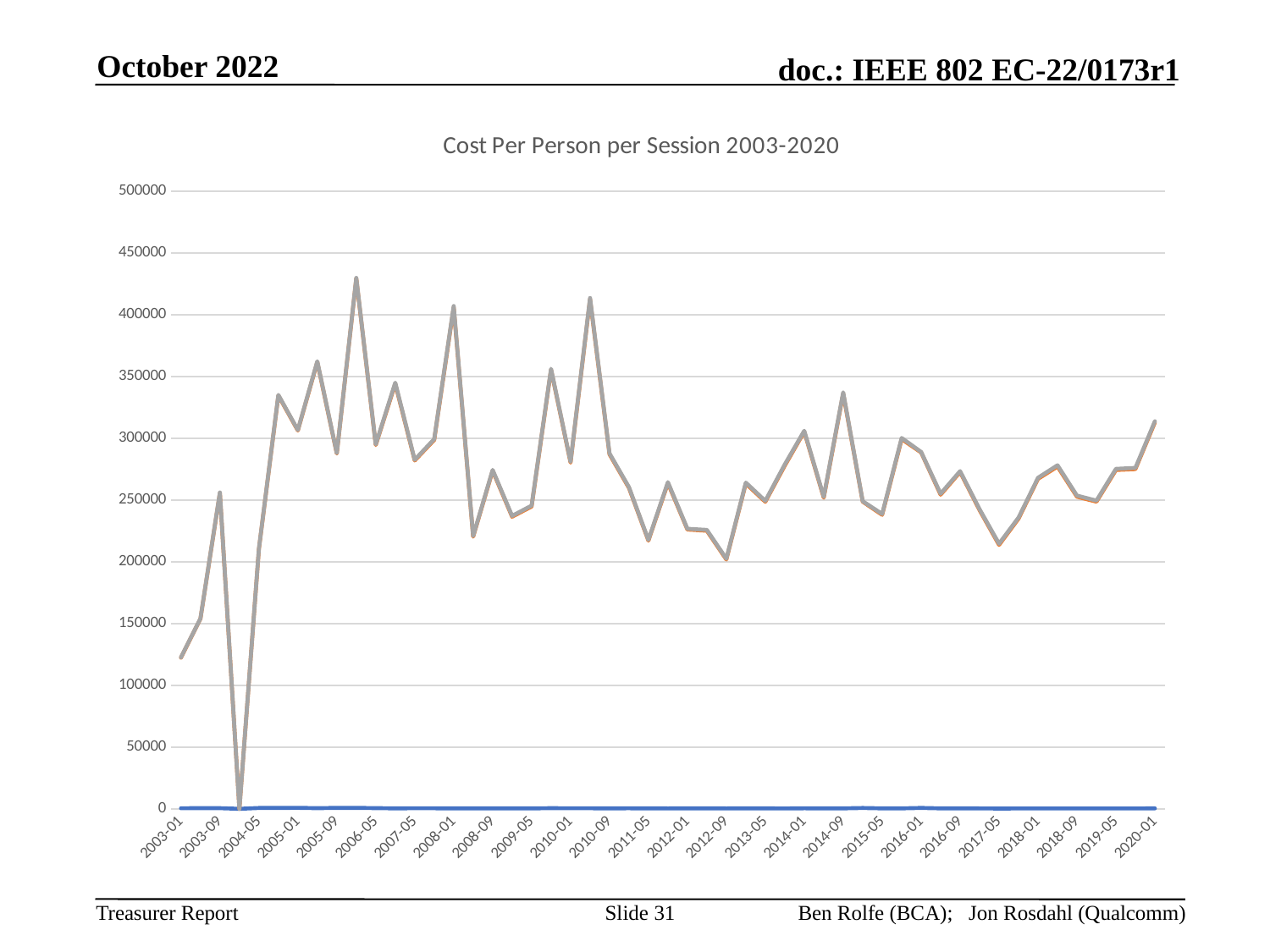
Is the value for 2017-05 greater or less than 250000? less Is the value for 2003-01 greater or less than 150000? less Is the value for 2020-01 greater or less than 300000? greater What type of chart is shown on the slide? line chart Which has the larger value, 2005-01 or 2003-01? 2005-01 What is the title of the chart? Cost Per Person per Session 2003-2020 What is the highest value shown on the y axis? 500000 Does the value rise or fall from 2003-01 to 2003-09? rise